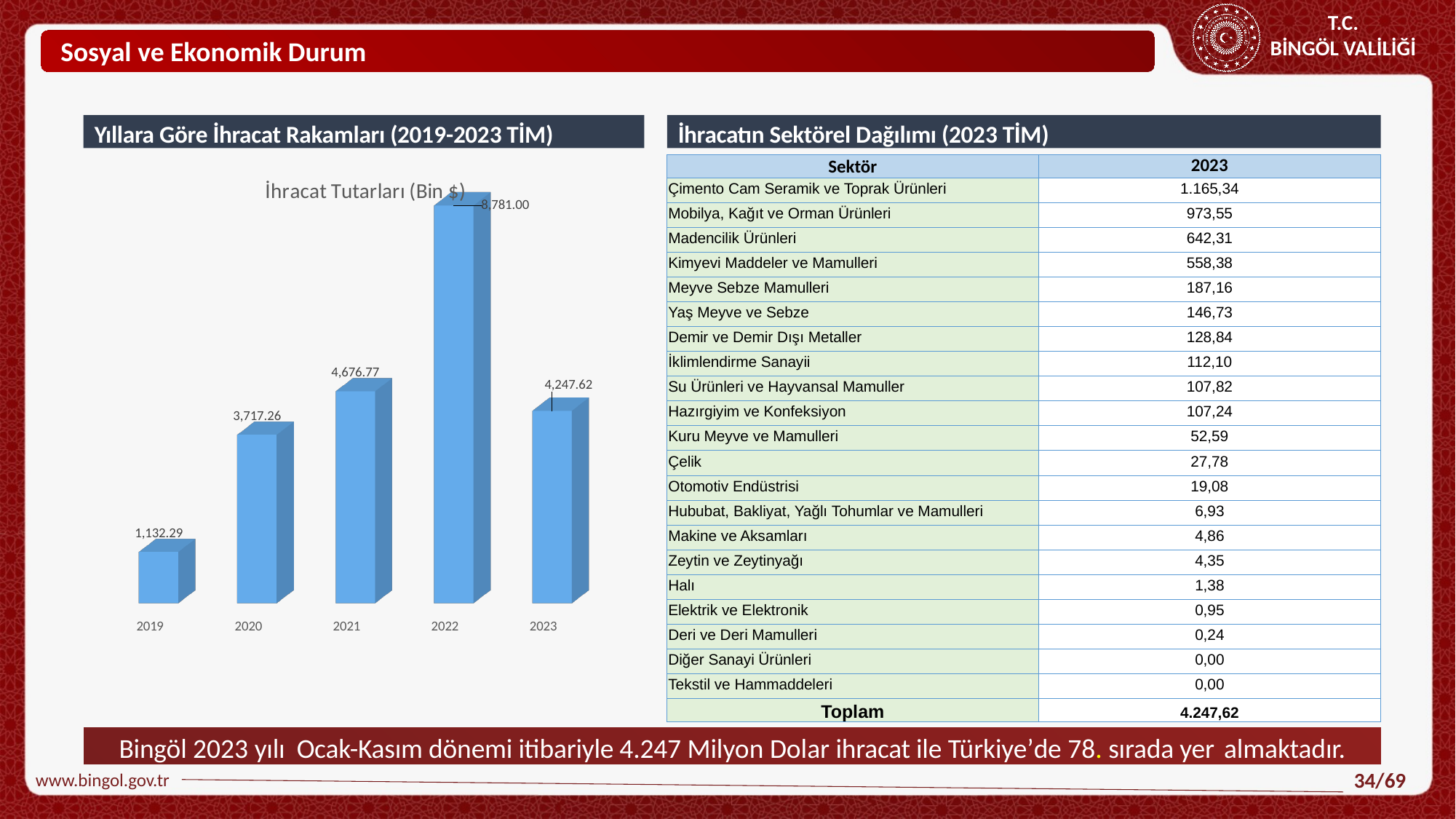
What is the difference between the 2021 and 2020 values in the İhracat Tutarları (Bin $) chart? 959.51 Which year has the lowest value in the İhracat Tutarları (Bin $) chart? 2019 How many years are shown in the İhracat Tutarları (Bin $) chart? 5 What is the value for 2023 in the İhracat Tutarları (Bin $) chart? 4,247.62 Which year has the highest value in the İhracat Tutarları (Bin $) chart? 2022 What is the difference between the 2022 and 2023 values in the İhracat Tutarları (Bin $) chart? 4,533.38 What is the value for 2022 in the İhracat Tutarları (Bin $) chart? 8,781.00 What is the title of the chart on the left side of the slide? İhracat Tutarları (Bin $) What is the value for 2019 in the İhracat Tutarları (Bin $) chart? 1,132.29 What kind of chart is the İhracat Tutarları (Bin $) chart? bar chart In the İhracat Tutarları (Bin $) chart, do the values rise or fall from 2019 to 2022? rise In the İhracat Tutarları (Bin $) chart, which is larger, the value for 2021 or the value for 2023? 2021